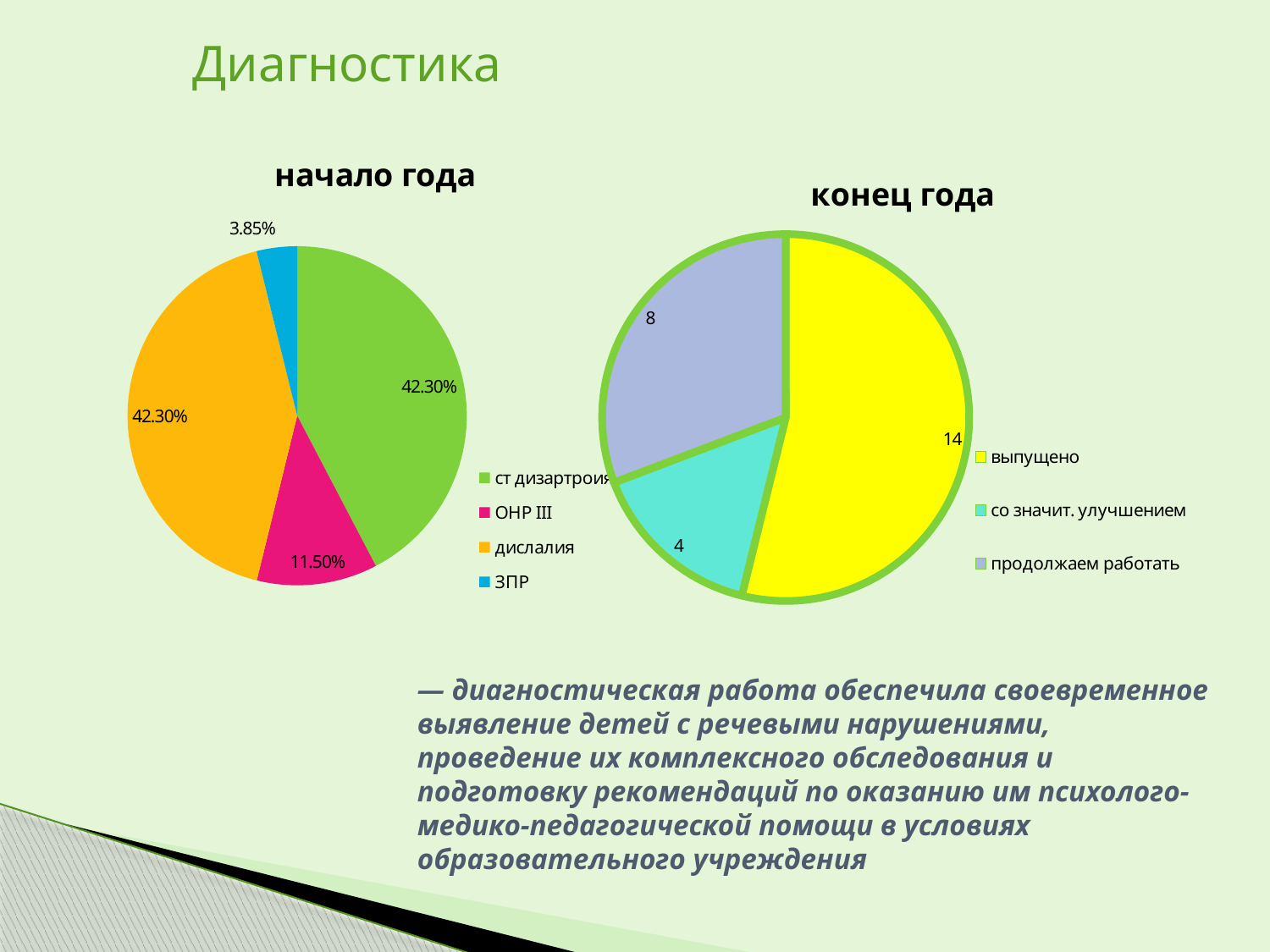
In the 'начало года' chart, what is the difference between ОНР III and ЗПР? 7.65% In the 'конец года' chart, what is the value for выпущено? 14 In the 'конец года' chart, which category has the largest slice? выпущено How many categories does the 'начало года' chart show? 4 In the 'конец года' chart, what is the difference between выпущено and продолжаем работать? 6 In the 'конец года' chart, what is the total of all slices? 26 What kind of chart is the 'начало года' chart? pie chart In the 'начало года' chart, what is the value for ЗПР? 3.85% In the 'конец года' chart, which category has the smallest slice? со значит. улучшением In the 'начало года' chart, which is larger: ОНР III or ЗПР? ОНР III In the 'начало года' chart, what is the value for ОНР III? 11.50% In the 'начало года' chart, which category has the smallest slice? ЗПР